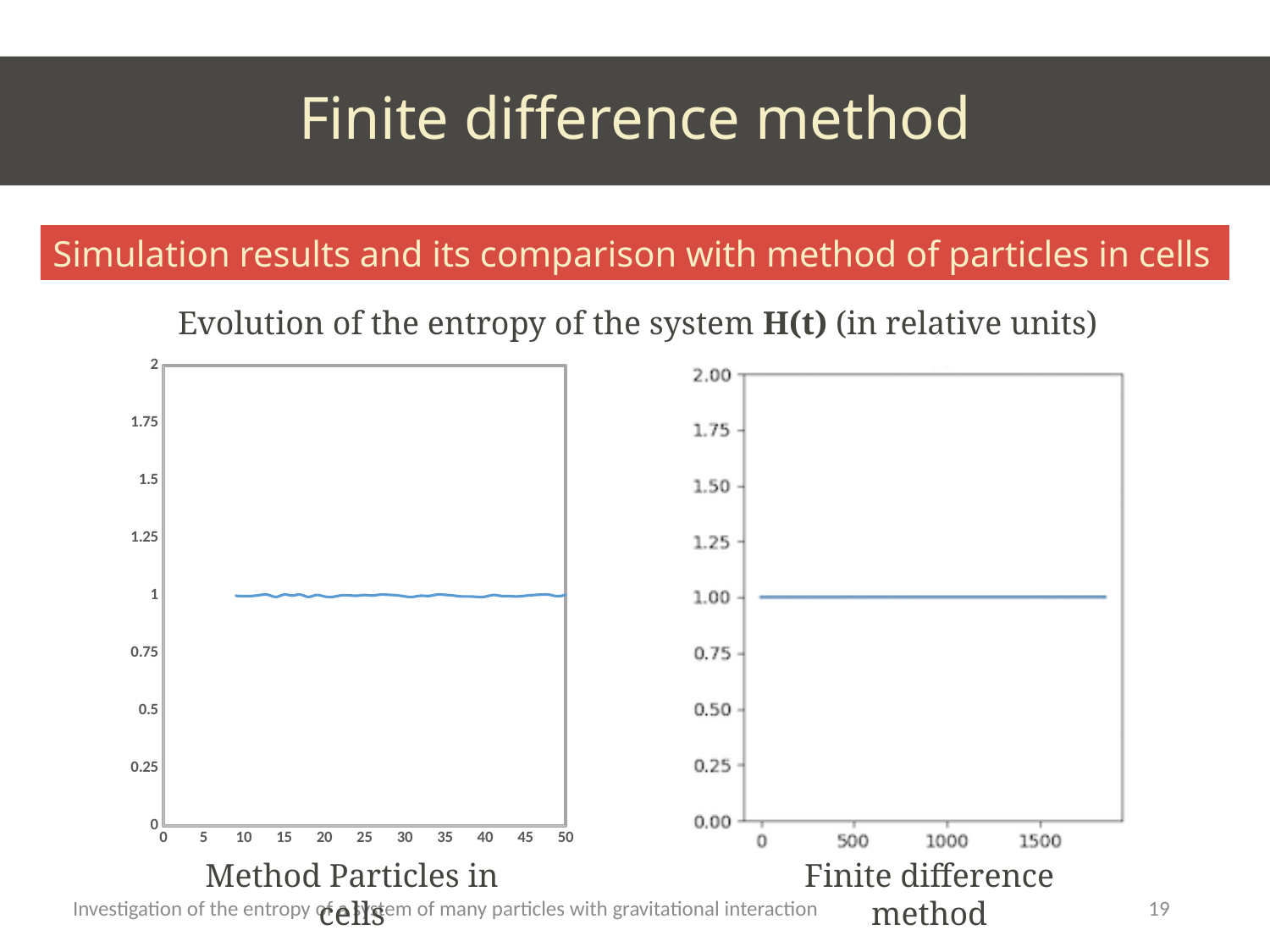
In the left chart (Method Particles in cells), is the plotted value at x = 30 greater or less than 0.75? greater How many charts are shown on the slide? 2 In the right chart (Finite difference method), is the plotted value at x = 500 greater or less than 0.50? greater What kind of chart is the left chart, captioned "Method Particles in cells"? line chart In the left chart (Method Particles in cells), does the plotted line rise, fall, or stay roughly flat along the x axis? stays roughly flat What is the highest tick label shown on the x axis of the right chart (Finite difference method)? 1500 What kind of chart is the right chart, captioned "Finite difference method"? line chart In the right chart (Finite difference method), is the plotted value at x = 1000 greater or less than 1.50? less In the right chart (Finite difference method), does the plotted line rise, fall, or stay flat along the x axis? stays flat What is the highest value shown on the y axis of the left chart (Method Particles in cells)? 2